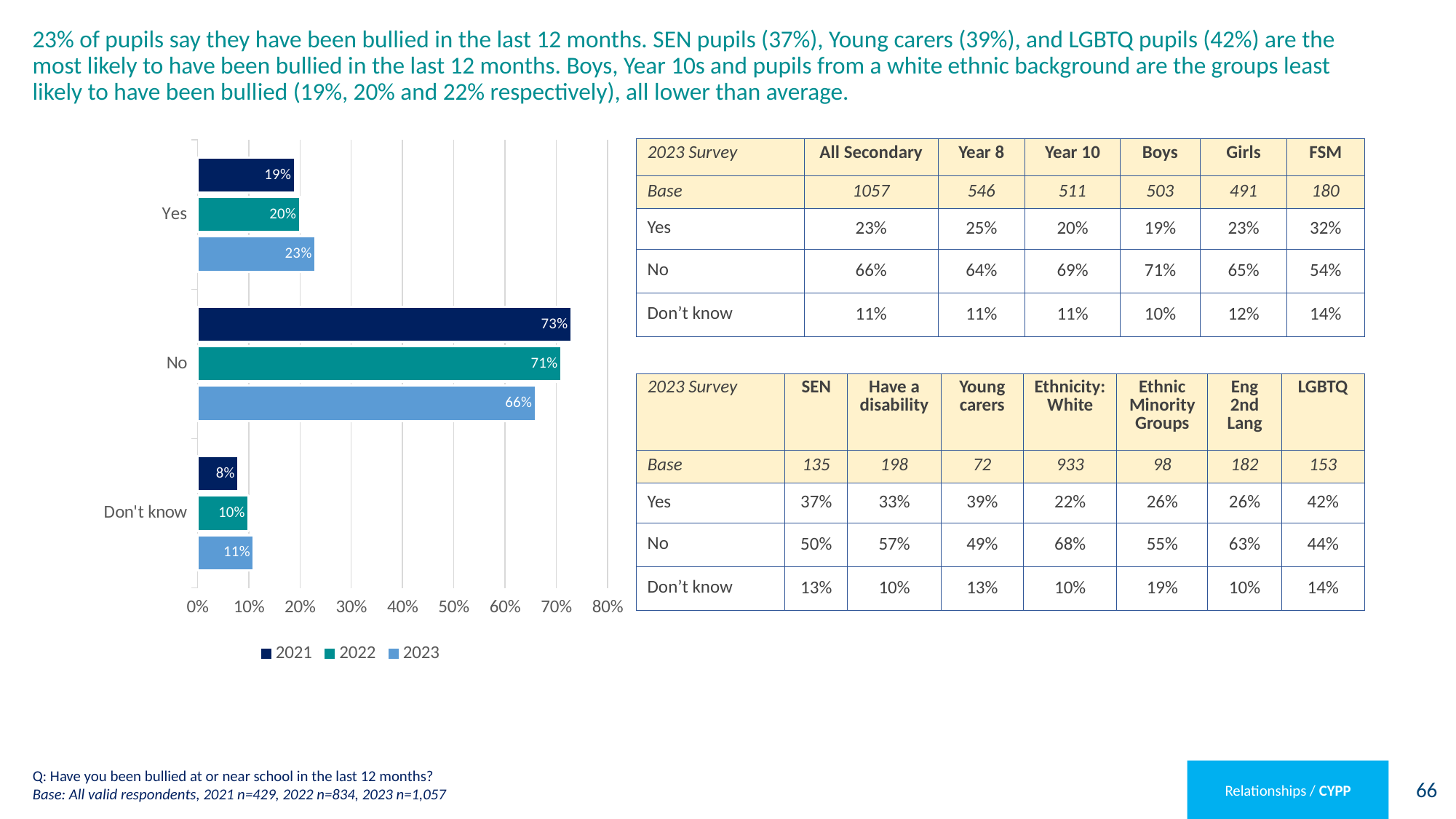
Which series is shown in the darkest blue colour? 2021 How many series does the legend list? 3 What is the value for 'No' in 2021? 73% Is the value for 'No' in 2022 greater or less than 60%? greater Which category has the lowest value for the 2021 series? Don't know What is the value for 'Don't know' in 2022? 10% Which is larger: the 'Yes' value for 2022 or the 'Yes' value for 2023? 2023 What is the difference between the 'No' values for 2021 and 2023? 7% How many categories are shown on the chart? 3 What kind of chart is shown on the slide? Bar chart Which category has the highest value for the 2023 series? No What is the value for 'Yes' in 2023? 23%